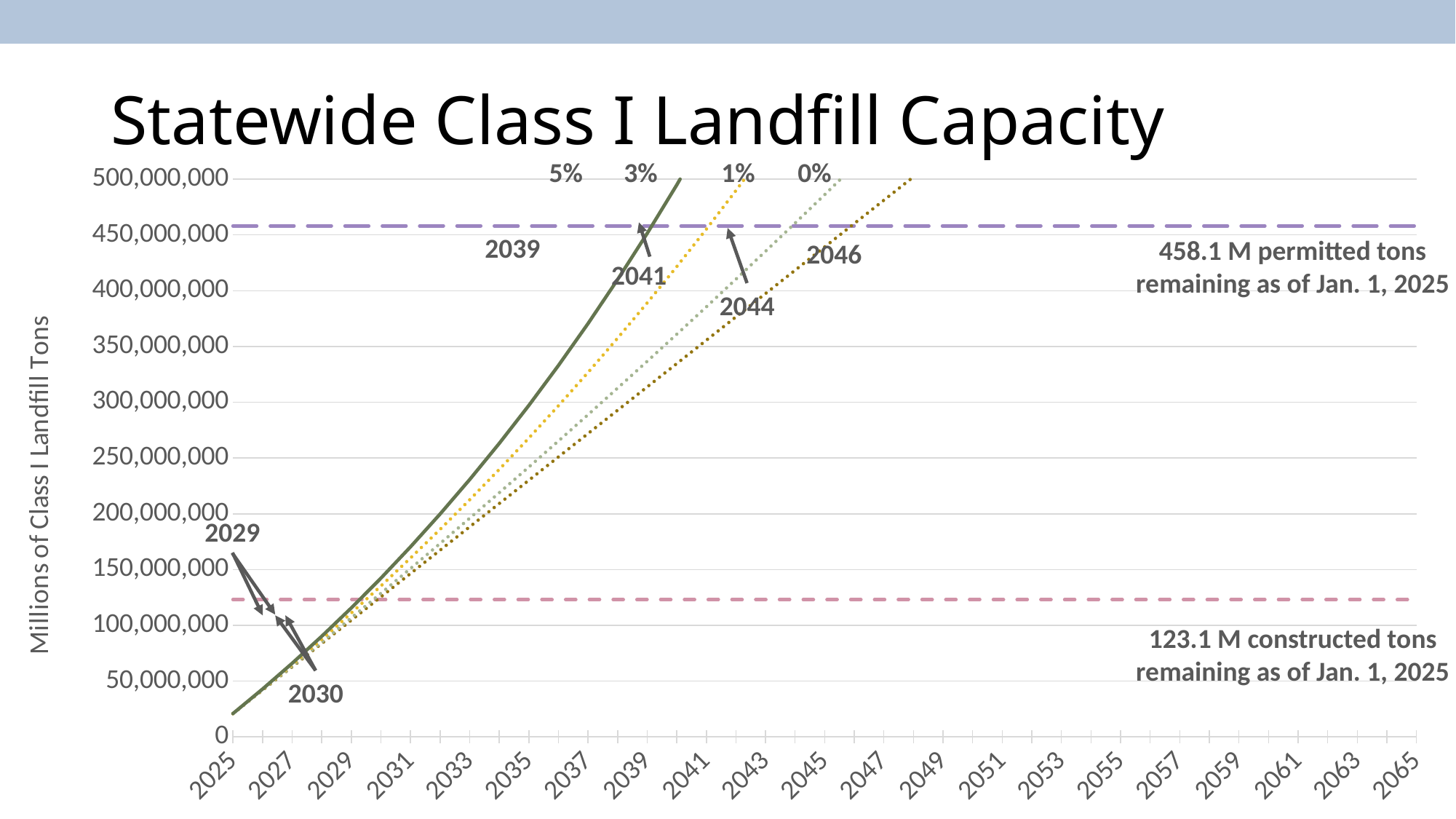
How many constructed tons were remaining as of Jan. 1, 2025, according to the lower dashed line? 123.1 M What is the title of the chart? Statewide Class I Landfill Capacity What kind of chart is shown on the slide? line chart How many growth-rate scenario lines are plotted on the chart? 4 In which year does the 3% growth line reach the permitted capacity line? 2041 In which year does the 5% growth line reach the permitted capacity line? 2039 What is the difference between the permitted tons remaining and the constructed tons remaining as of Jan. 1, 2025? 335 M tons Which growth scenario reaches the permitted capacity line earliest? 5% How many permitted tons were remaining as of Jan. 1, 2025, according to the upper dashed line? 458.1 M What is the label on the vertical axis of the chart? Millions of Class I Landfill Tons In which year does the 0% growth line reach the permitted capacity line? 2046 Is the value of the 5% growth line in 2037 greater or less than 350,000,000? greater